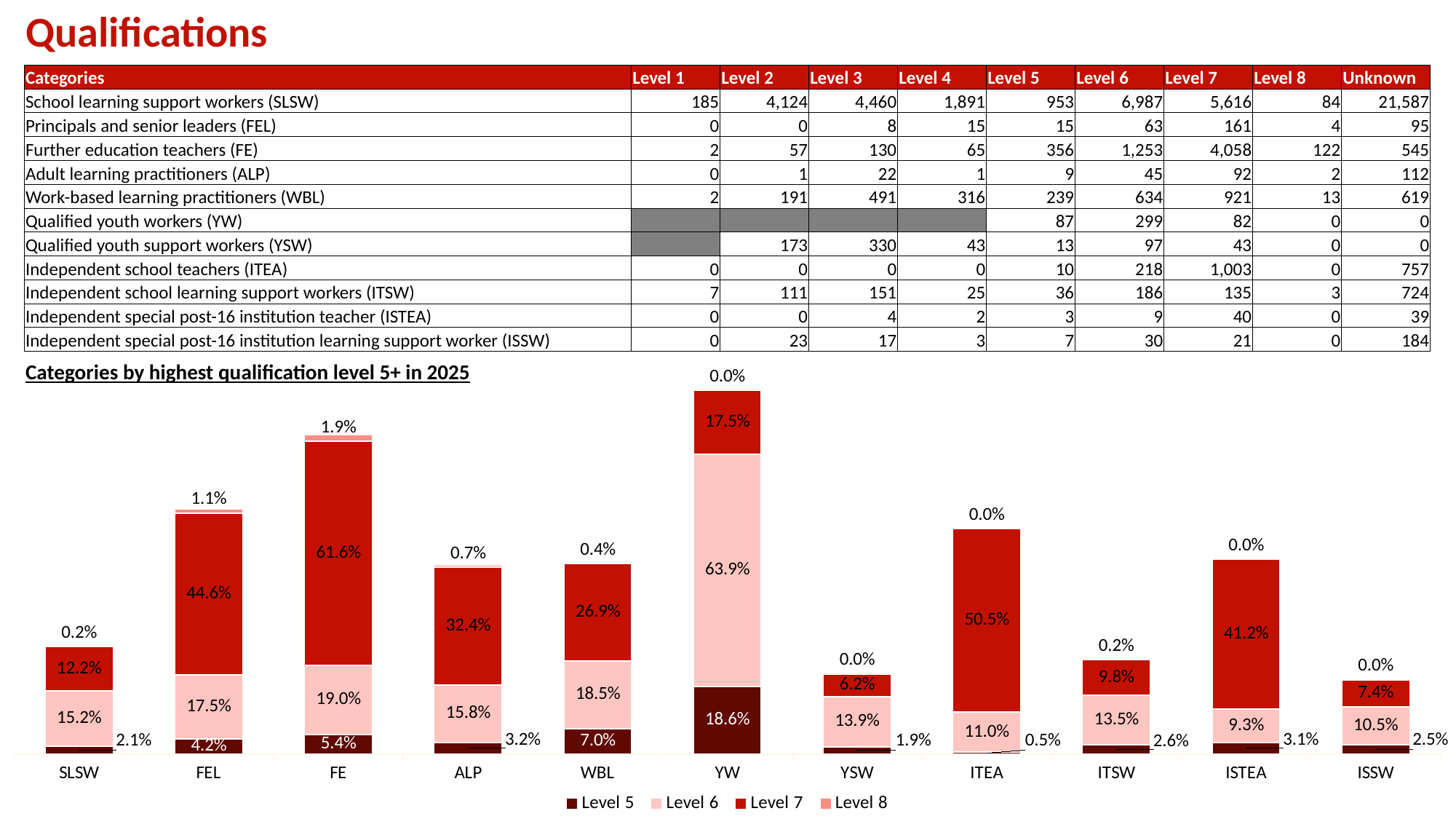
What is the Level 7 value for FE in the chart? 61.6% Which is larger: the Level 7 value for ITEA or for ISTEA? ITEA What type of chart is shown on the slide? Stacked bar chart How many series does the chart legend list? 4 Which category has the highest Level 7 value in the chart? FE Which category has the lowest Level 6 value in the chart? ISTEA What is the total of the stacked bar for YW? 100.0% How many categories are shown on the x axis of the chart? 11 What is the Level 5 value for WBL in the chart? 7.0% What is the Level 8 value for FE in the chart? 1.9% What is the difference between the Level 7 values for FE and FEL? 17.0% What is the Level 6 value for YW in the chart? 63.9%